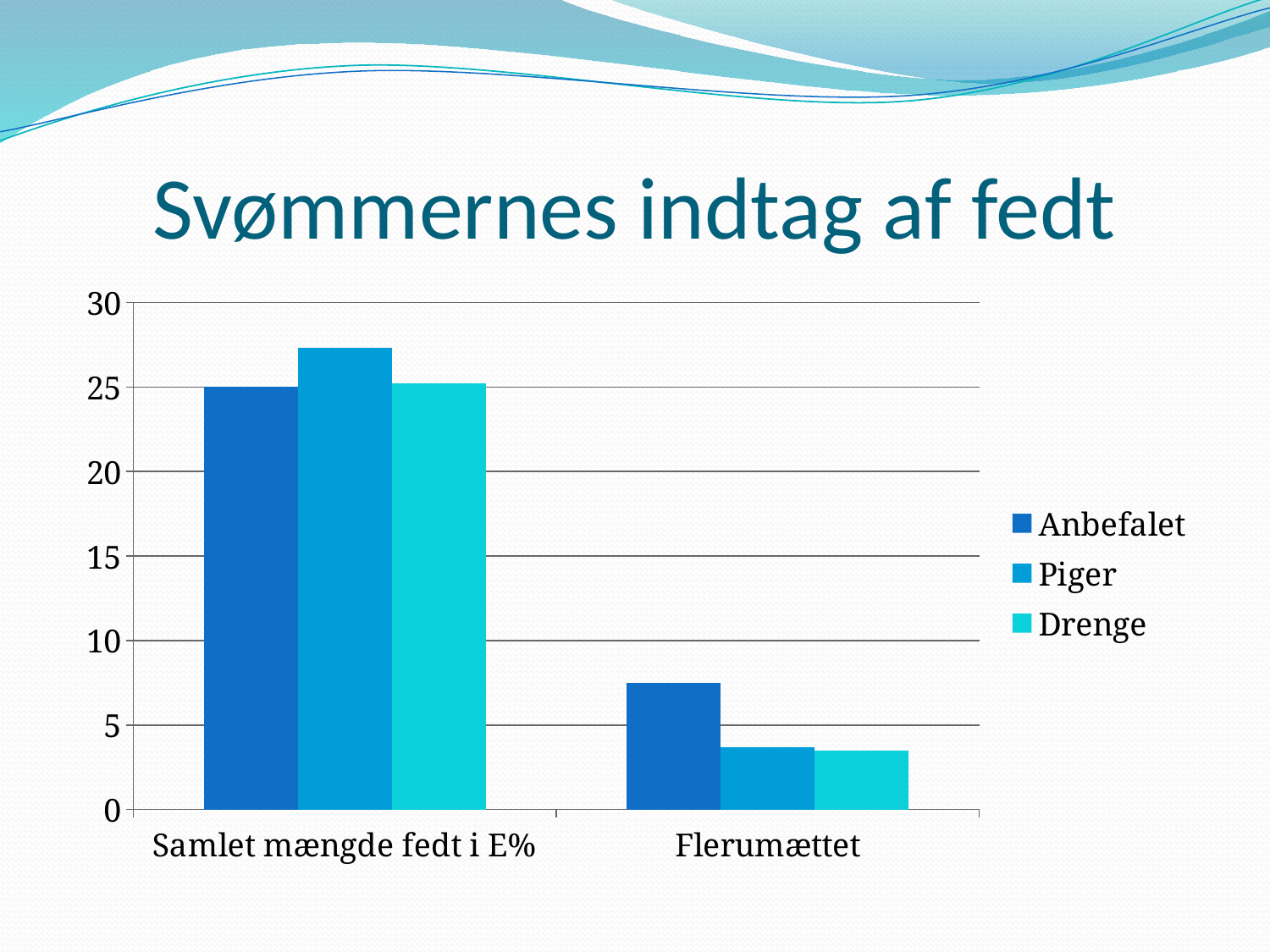
Which series has the highest value for Samlet mængde fedt i E%? Piger How many categories are shown on the x axis? 2 Is the Anbefalet value for Flerumættet greater or less than 5? greater Which series has the highest value for Flerumættet? Anbefalet What is the Anbefalet value for Samlet mængde fedt i E%? 25 What is the title of the chart on the slide? Svømmernes indtag af fedt Is the Drenge value for Flerumættet greater or less than 5? less What kind of chart is shown on the slide? Bar chart How many series does the legend list? 3 Is the Piger value for Samlet mængde fedt i E% greater or less than 25? greater Which series are listed in the legend? Anbefalet, Piger, Drenge For Flerumættet, which is larger: the Anbefalet value or the Piger value? Anbefalet